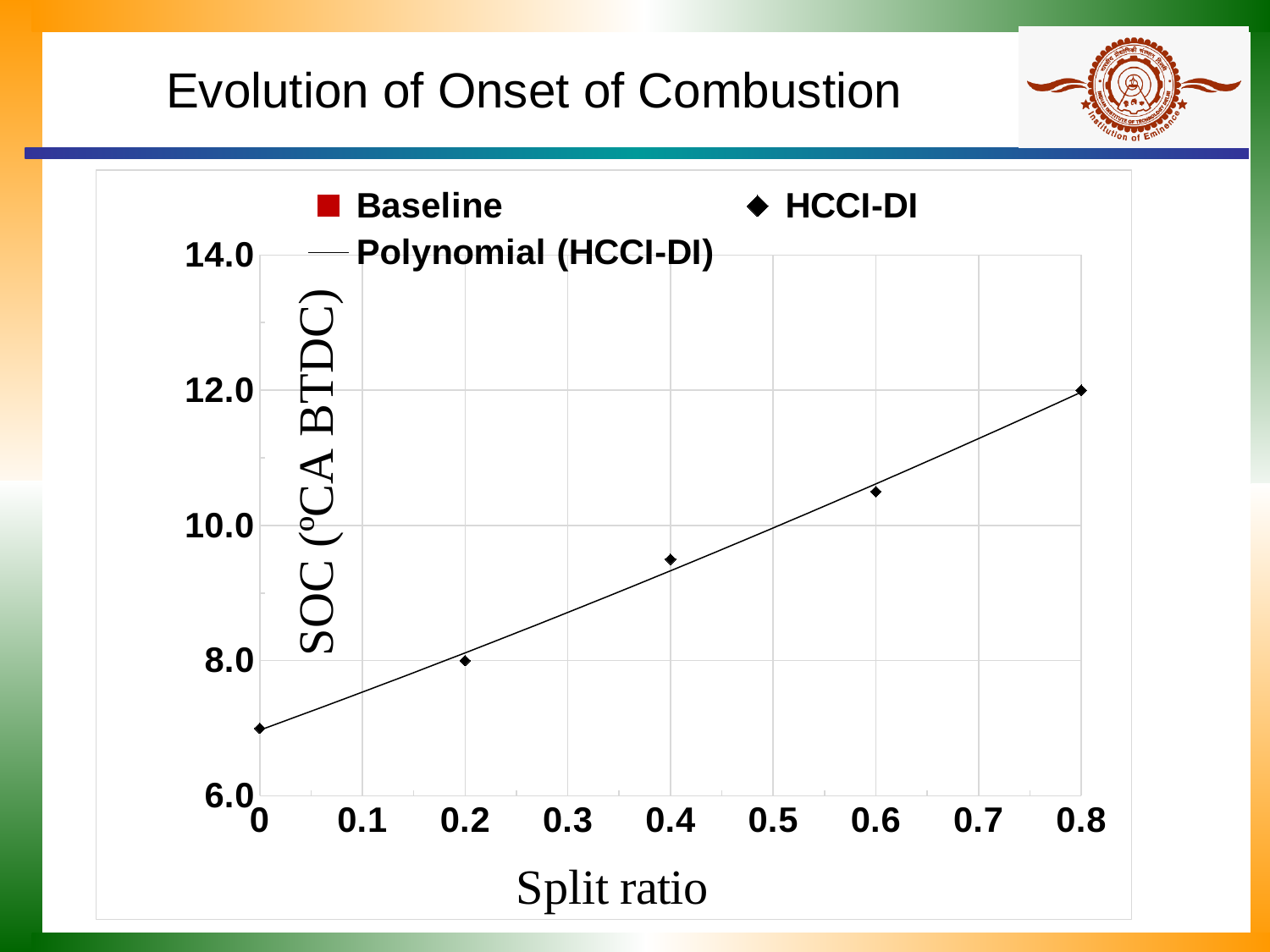
At which split ratio is the HCCI-DI SOC value lowest? 0 Is the SOC value for HCCI-DI at split ratio 0.4 greater or less than 10.0? less What is the SOC value for HCCI-DI at a split ratio of 0.2? 8.0 What is the SOC value for HCCI-DI at a split ratio of 0.8? 12.0 How many HCCI-DI data points are plotted? 5 Is the SOC value for HCCI-DI at split ratio 0.6 greater or less than 10.0? greater Does the SOC for HCCI-DI rise or fall as the split ratio increases? Rises Is the SOC value for HCCI-DI at split ratio 0 greater or less than 8.0? less What is the difference in SOC for HCCI-DI between split ratios 0.8 and 0.2? 4.0 What type of chart is shown on the slide? Scatter chart How many entries does the legend list? 3 At which split ratio is the HCCI-DI SOC value highest? 0.8